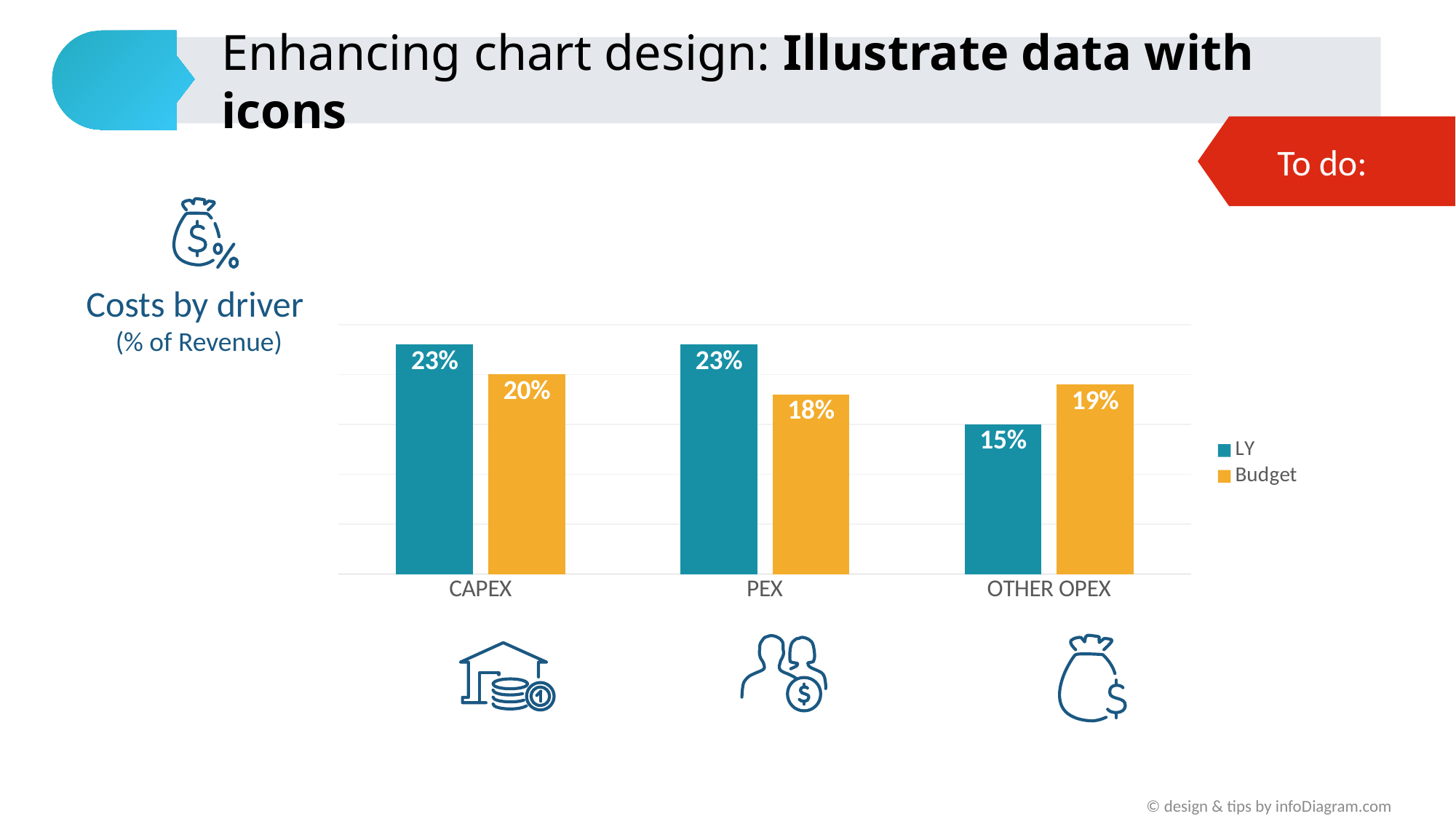
How many categories are shown on the x axis? 3 What are the two series named in the legend? LY and Budget What is the Budget value for OTHER OPEX? 19% Which category has the lowest LY value? OTHER OPEX What is the difference between the LY and Budget values for PEX? 5% What is the LY value for OTHER OPEX? 15% What is the Budget value for PEX? 18% How many series does the legend list? 2 What kind of chart is shown on the slide? Bar chart Which category has the highest Budget value? CAPEX What is the LY value for CAPEX? 23% For OTHER OPEX, which is larger, the LY value or the Budget value? Budget